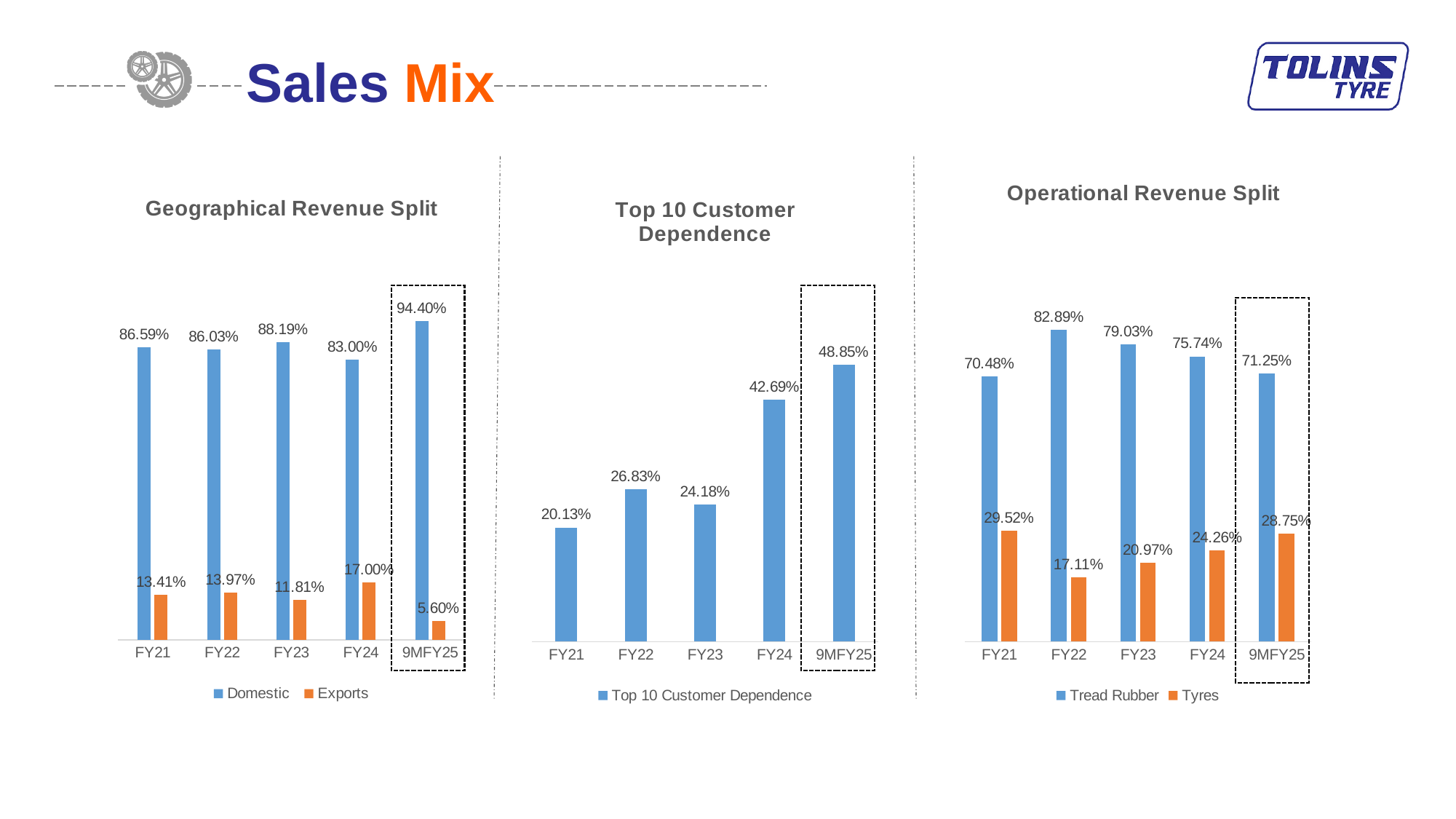
In the Top 10 Customer Dependence chart, which year has the lowest value? FY21 In the Operational Revenue Split chart, is the Tyres value larger in FY21 or in 9MFY25? FY21 In the Top 10 Customer Dependence chart, what is the value for FY22? 26.83% In the Geographical Revenue Split chart, what is the Exports value for FY23? 11.81% How many series does the legend of the Operational Revenue Split chart list? 2 In the Top 10 Customer Dependence chart, what is the difference between the 9MFY25 and FY24 values? 6.16% In the Operational Revenue Split chart, which year has the highest Tread Rubber value? FY22 In the Geographical Revenue Split chart, which year has the highest Exports value? FY24 In the Geographical Revenue Split chart, what is the difference between the Domestic and Exports values for FY24? 66.00% In the Geographical Revenue Split chart, what is the Domestic value for 9MFY25? 94.40% In the Operational Revenue Split chart, what is the Tyres value for FY22? 17.11% In the Top 10 Customer Dependence chart, how many categories are shown on the x axis? 5